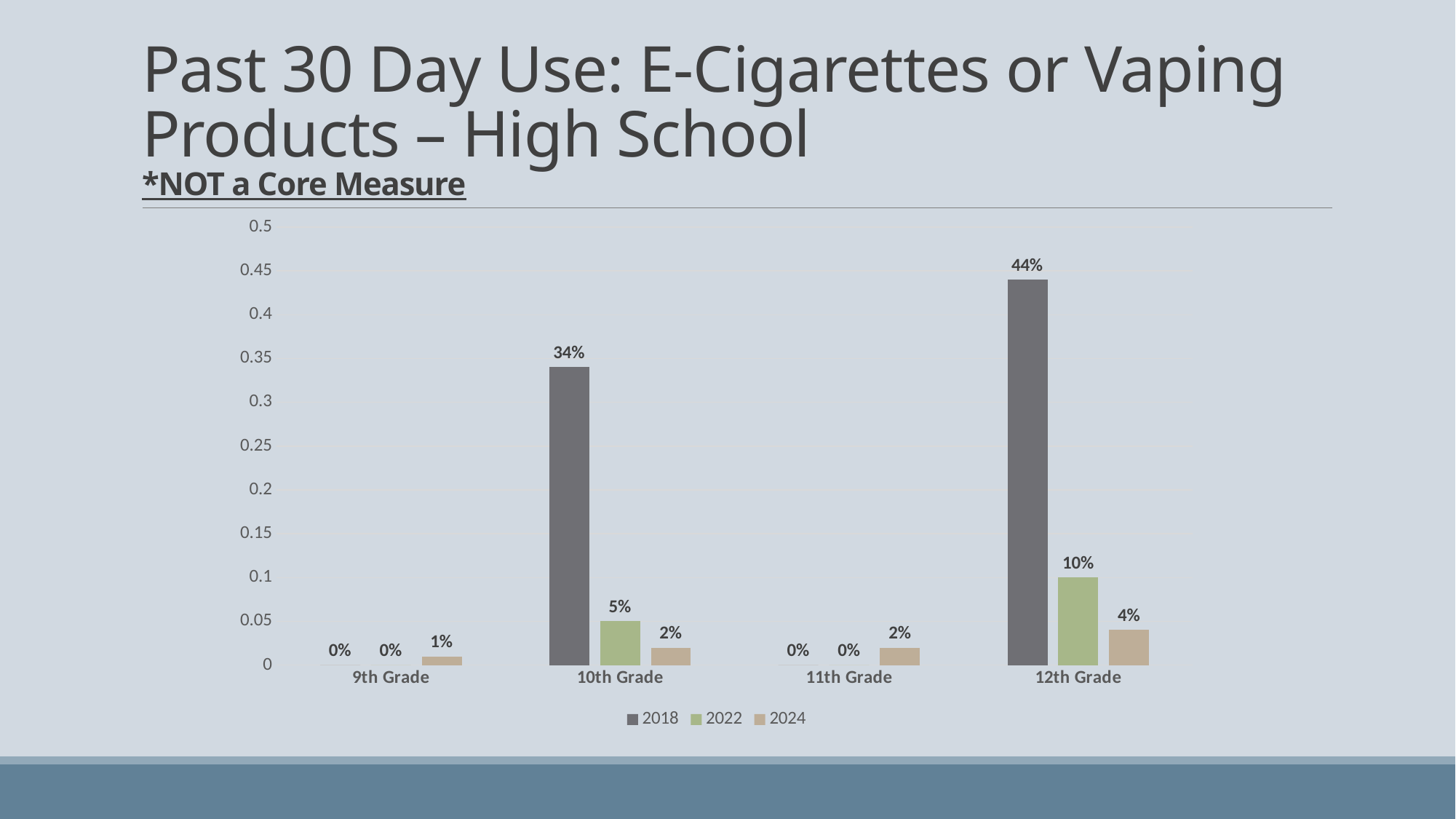
How many series does the legend list? 3 Which is larger, the 2024 value for 12th Grade or the 2024 value for 10th Grade? 12th Grade Which years are listed in the legend? 2018, 2022, 2024 What is the 2024 value for 9th Grade? 1% What kind of chart is shown on the slide? Bar chart What is the 2022 value for 10th Grade? 5% What is the 2018 value for 12th Grade? 44% What is the difference between the 2018 and 2022 values for 12th Grade? 34% Which grade has the highest 2018 value? 12th Grade What is the 2024 value for 11th Grade? 2% Which grade has the lowest 2024 value? 9th Grade How many grade categories are shown on the x axis? 4